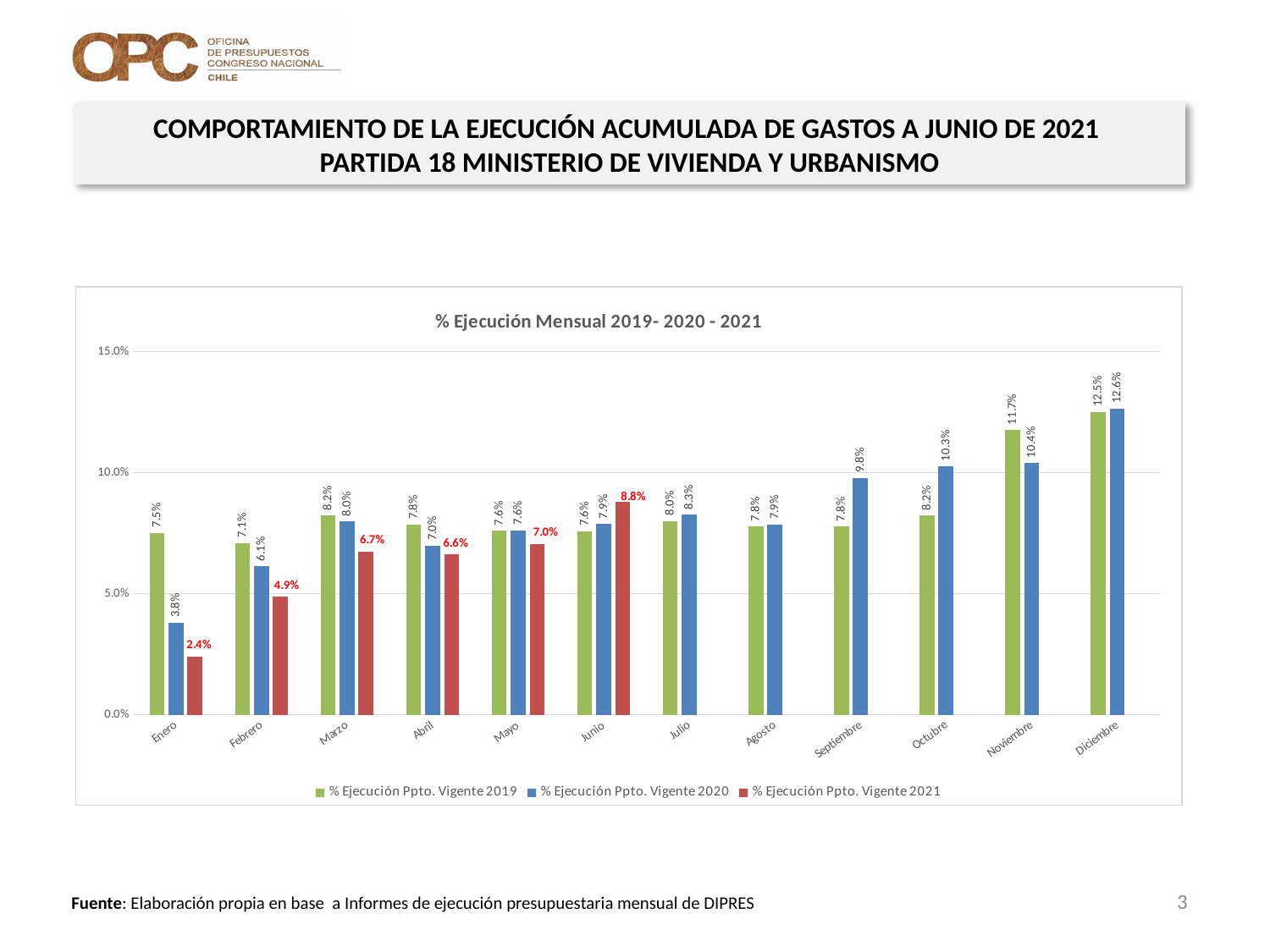
How many series does the legend list? 3 In which month is the % Ejecución Ppto. Vigente 2021 series highest? Junio What is the value for % Ejecución Ppto. Vigente 2021 in Enero? 2.4% How many months are shown on the x axis? 12 What is the difference between the 2019 and 2020 values in Enero? 3.7% What is the value for % Ejecución Ppto. Vigente 2019 in Noviembre? 11.7% What is the value for % Ejecución Ppto. Vigente 2020 in Octubre? 10.3% Is the value for % Ejecución Ppto. Vigente 2020 in Septiembre greater or less than 10.0%? less What is the title of the chart? % Ejecución Mensual 2019- 2020 - 2021 What kind of chart is shown? Bar chart In which month is the % Ejecución Ppto. Vigente 2020 series lowest? Enero Which is larger in Junio: the 2019 value or the 2021 value? 2021 value